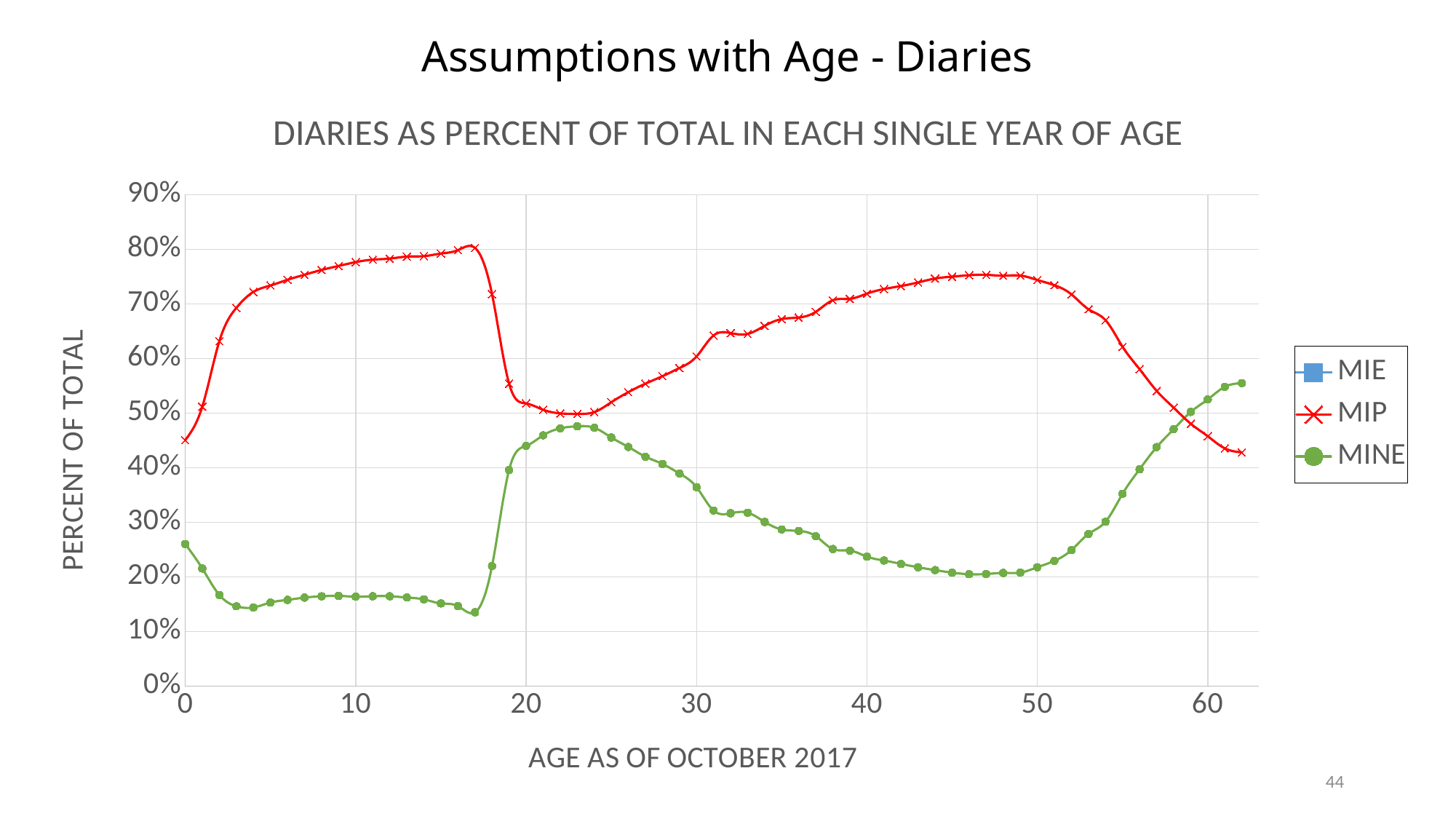
Does the MIP line rise or fall between age 50 and age 62? fall How many series does the legend list? 3 At age 62, which series has the larger value, MIP or MINE? MINE At age 10, which series has the larger value, MIP or MINE? MIP Is the MIP value at age 10 greater or less than 70%? greater Is the MINE value at age 10 greater or less than 20%? less Does the MINE line rise or fall between age 50 and age 62? rise Is the MINE value at age 46 greater or less than 30%? less What is the label of the x axis? AGE AS OF OCTOBER 2017 What kind of chart is shown on the slide? line chart